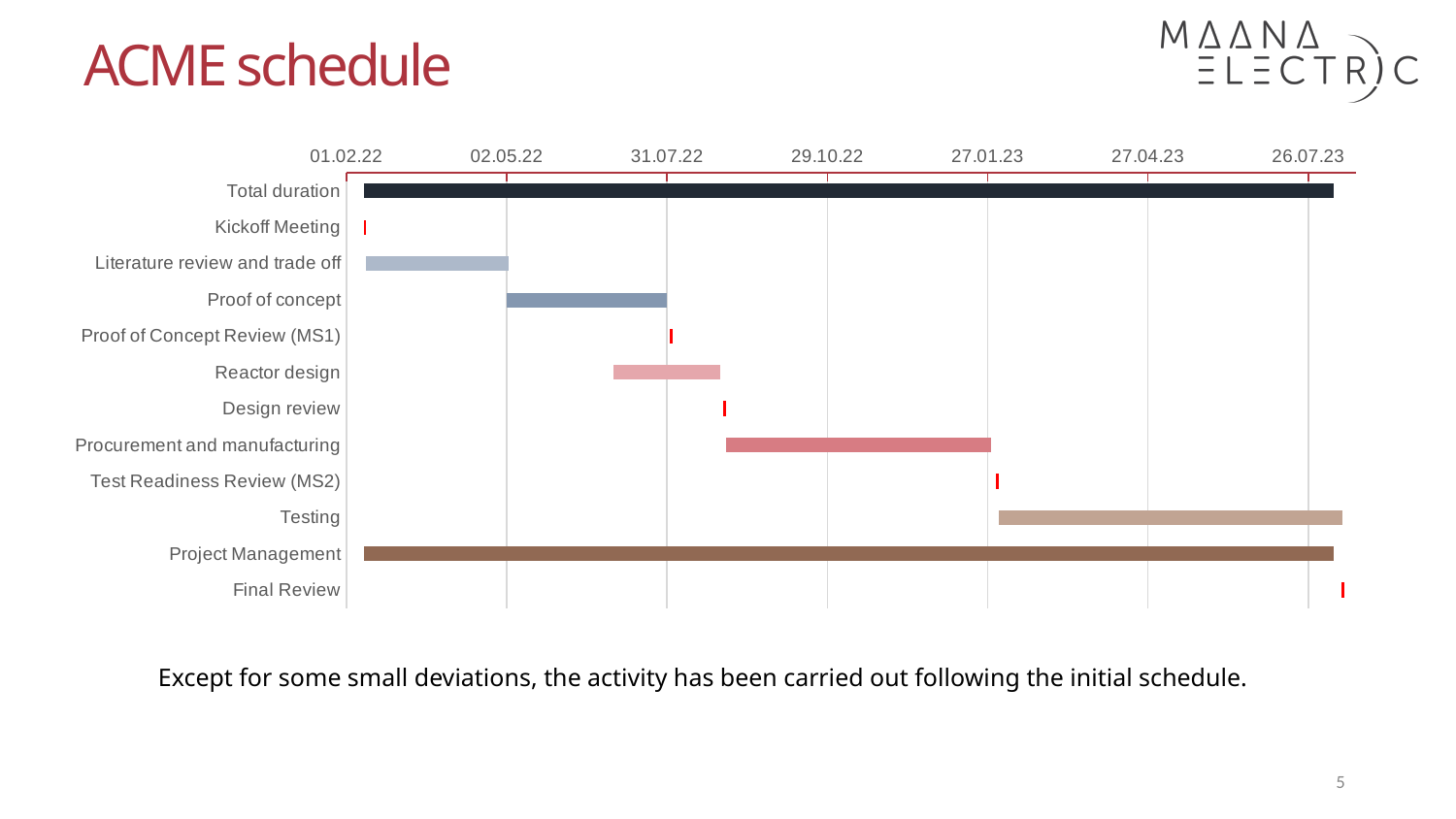
How many tasks are listed on the vertical axis of the chart? 12 What is the first date label shown on the horizontal axis? 01.02.22 Which task is listed at the bottom of the chart? Final Review Which task has the longer bar, Testing or Procurement and manufacturing? Testing What is the title of the slide containing the schedule chart? ACME schedule What kind of chart is shown on the slide? Bar chart (Gantt chart) Which task is listed at the top of the chart? Total duration Does the Reactor design bar start before or after 31.07.22? before Does the Literature review and trade off bar end before or after 31.07.22? before Does the Kickoff Meeting milestone occur before or after 02.05.22? before Among the tasks shown as bars (not milestone markers), excluding Total duration and Project Management, which has the shortest bar? Reactor design Which task has the longer bar, Reactor design or Procurement and manufacturing? Procurement and manufacturing